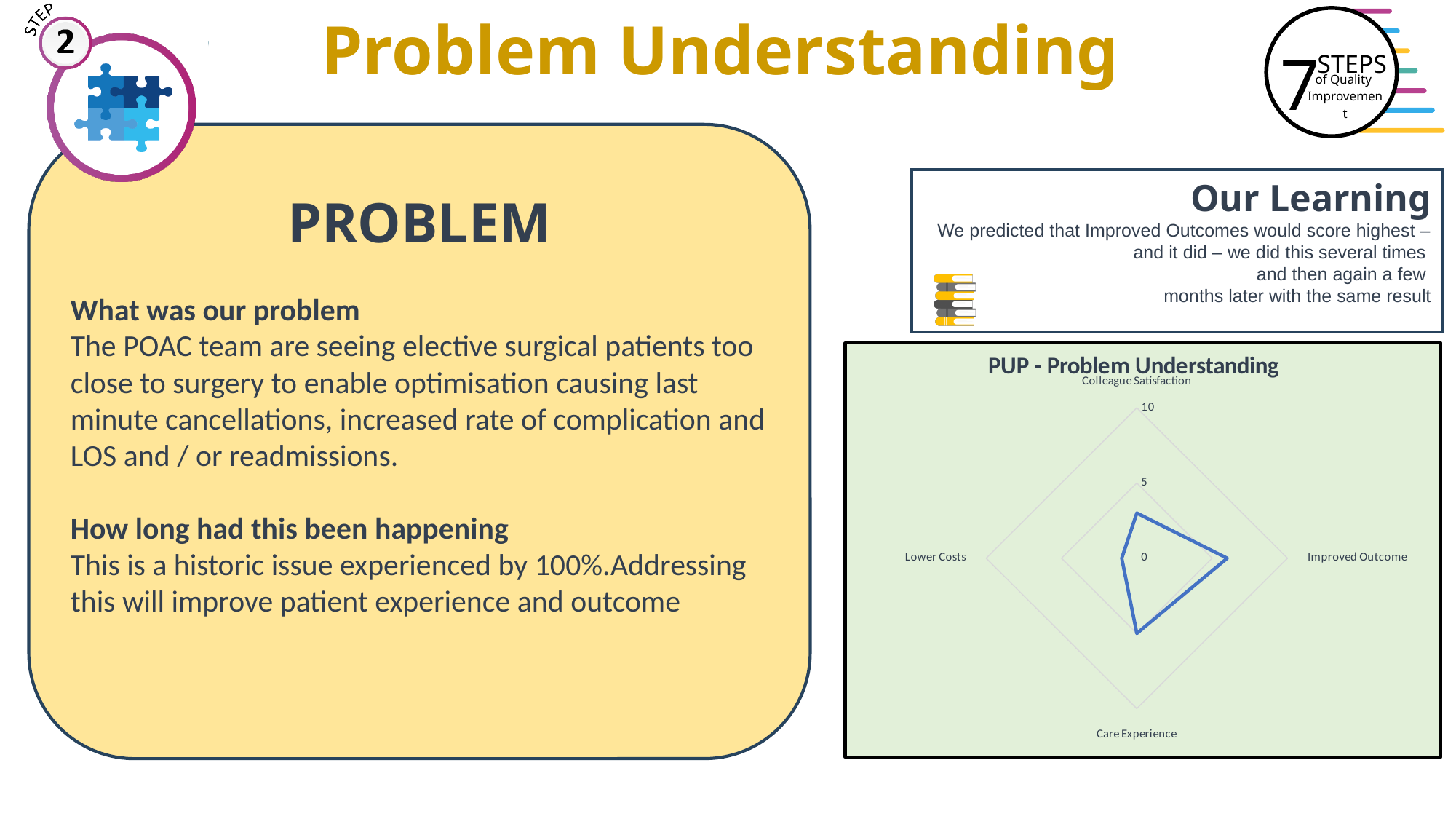
Is the value for Improved Outcome greater or less than 10? less Which category has the highest value in the radar chart? Improved Outcome What kind of chart is shown on the slide? Radar chart Which is larger, the value for Care Experience or the value for Colleague Satisfaction? Care Experience Which category has the lowest value in the radar chart? Lower Costs Is the value for Colleague Satisfaction greater or less than 5? less Is the value for Lower Costs greater or less than 5? less Which is larger, the value for Improved Outcome or the value for Lower Costs? Improved Outcome What is the maximum value shown on the radar chart's scale? 10 What is the title of the chart on the slide? PUP - Problem Understanding How many categories (axes) does the radar chart have? 4